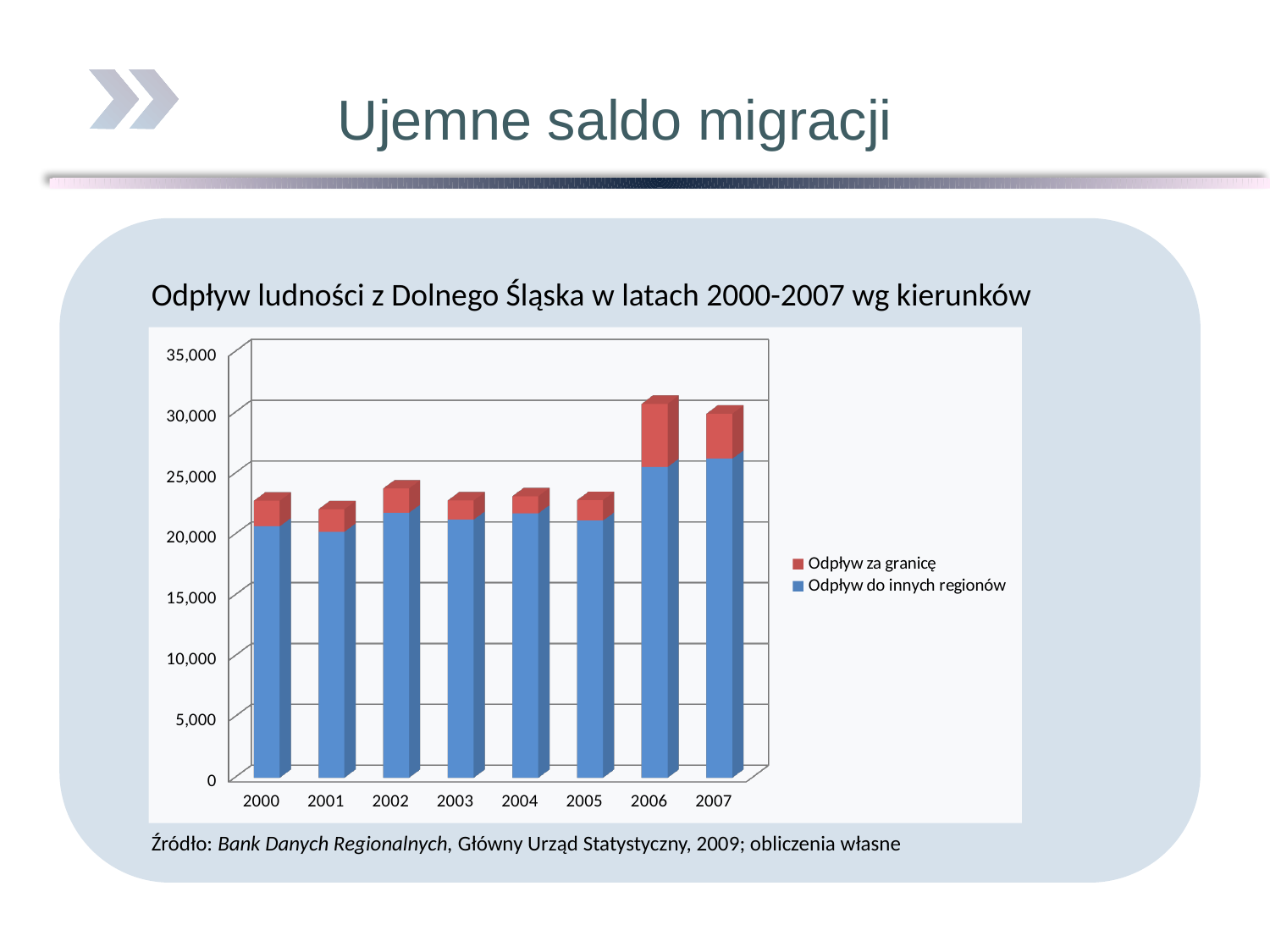
Does the total outflow rise or fall from 2005 to 2006? rise Which year has the highest total outflow in the chart? 2006 Is the total outflow for 2005 greater or less than 25,000? less What kind of chart is shown on the slide? bar chart Is the total outflow for 2000 greater or less than 20,000? greater How many years are shown on the x axis of the chart? 8 Is the value of 'Odpływ do innych regionów' for 2007 greater or less than 25,000? greater Which year has the lowest total outflow in the chart? 2001 Which series is shown in red in the chart? Odpływ za granicę Which year has the larger total outflow, 2001 or 2006? 2006 How many series does the chart legend list? 2